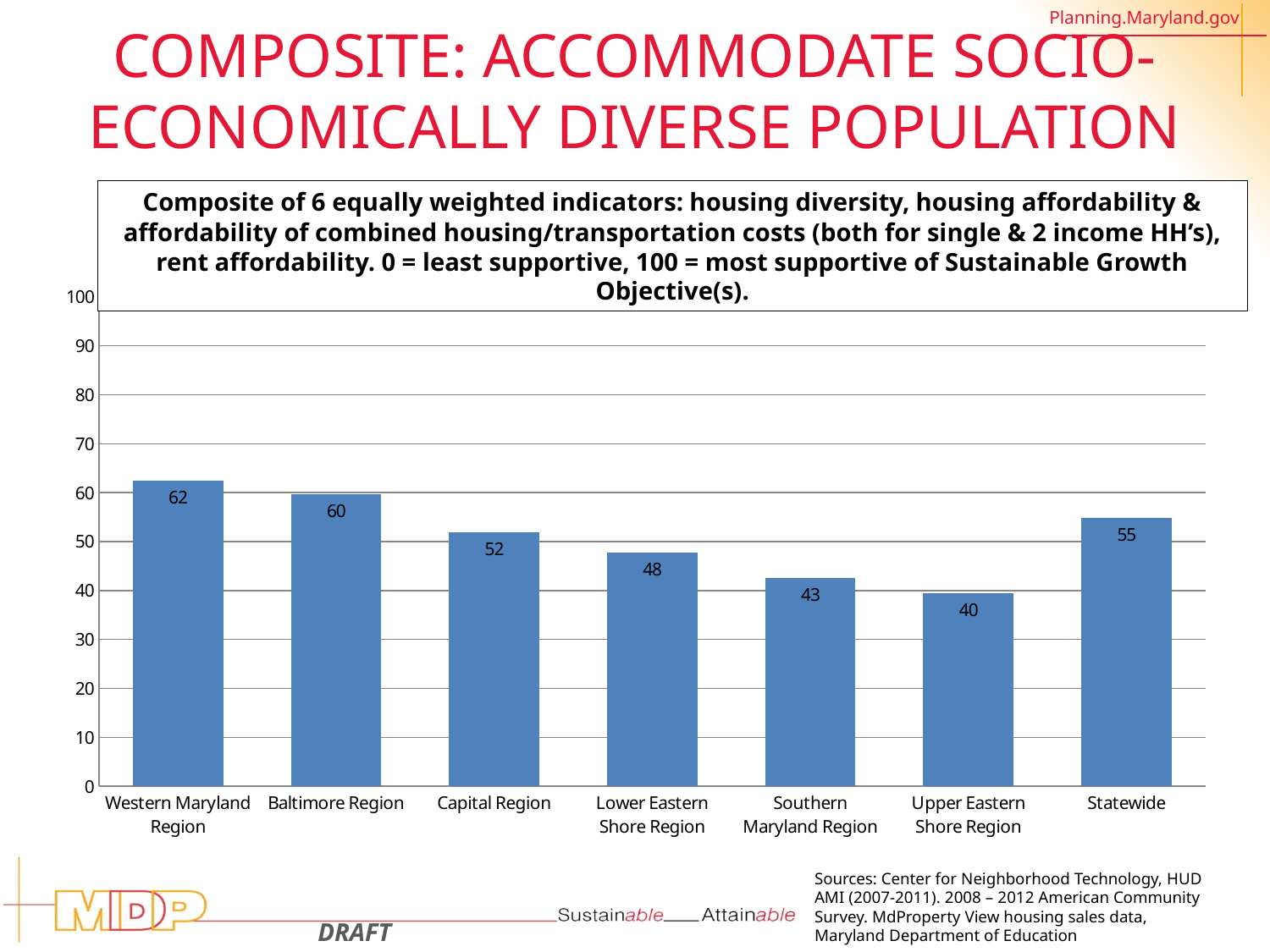
Which region has the lowest composite score? Upper Eastern Shore Region What is the composite score for the Western Maryland Region? 62 What is the Statewide composite score? 55 What is the composite score for the Upper Eastern Shore Region? 40 Do the values rise or fall from the Western Maryland Region to the Upper Eastern Shore Region? fall What is the difference between the Baltimore Region score and the Southern Maryland Region score? 17 What kind of chart is shown on the slide? bar chart Which has a higher composite score, the Capital Region or the Lower Eastern Shore Region? Capital Region How many categories are shown on the x axis of the chart? 7 Which region has the highest composite score? Western Maryland Region Is the value for the Southern Maryland Region greater or less than 50? less How many equally weighted indicators make up the composite, according to the chart title? 6